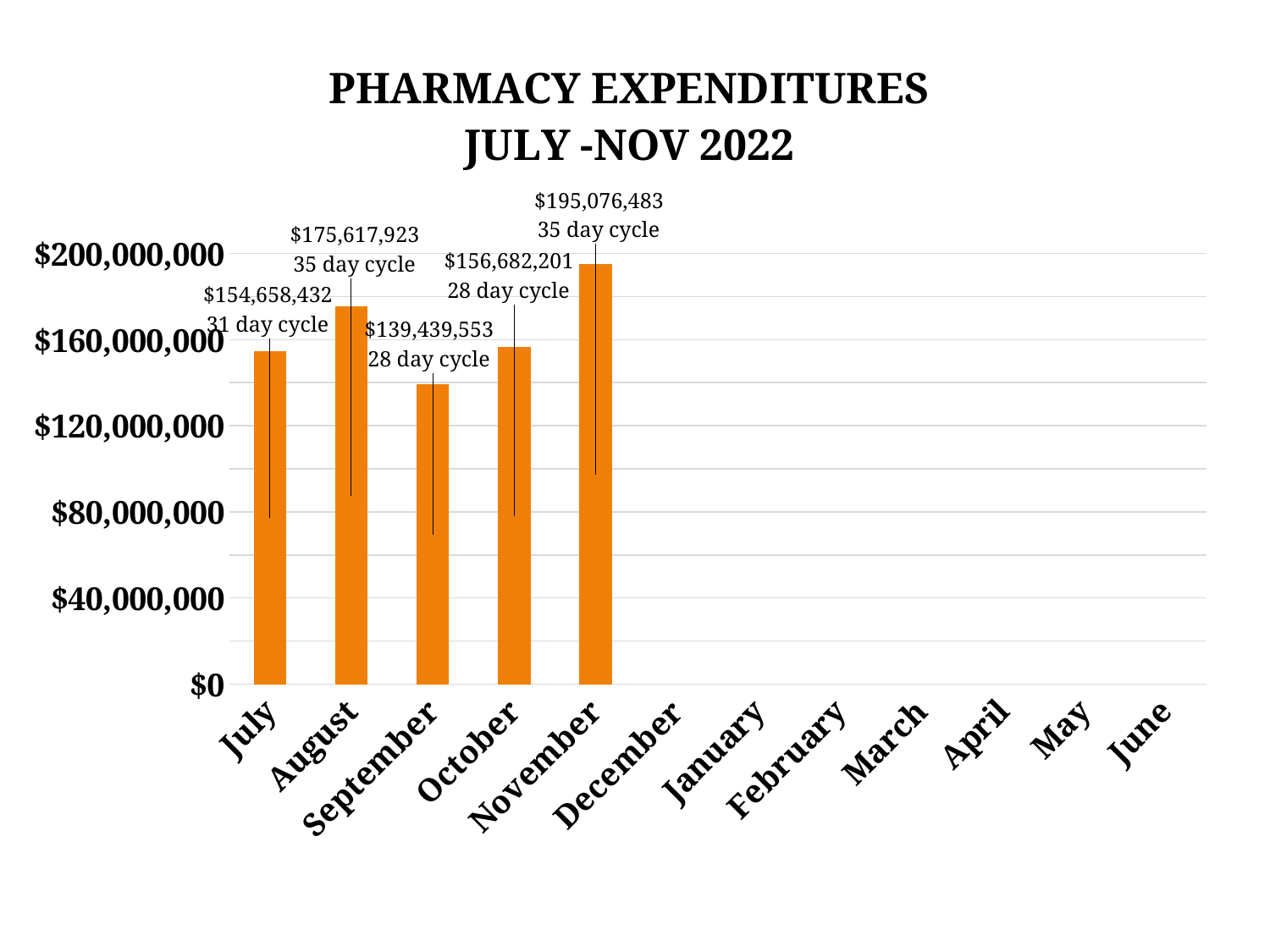
Which is larger, the expenditure for October or for July? October Which month has the lowest pharmacy expenditure? September What kind of chart is shown on the slide? Bar chart What is the pharmacy expenditure for September? $139,439,553 How many days is the billing cycle noted for October? 28 day cycle What is the pharmacy expenditure for November? $195,076,483 What is the pharmacy expenditure for July? $154,658,432 Is the value for August greater or less than $160,000,000? greater How many months have a bar plotted on the chart? 5 Which month has the highest pharmacy expenditure? November What is the difference between the August and July expenditures? $20,959,491 What is the difference between the November and September expenditures? $55,636,930